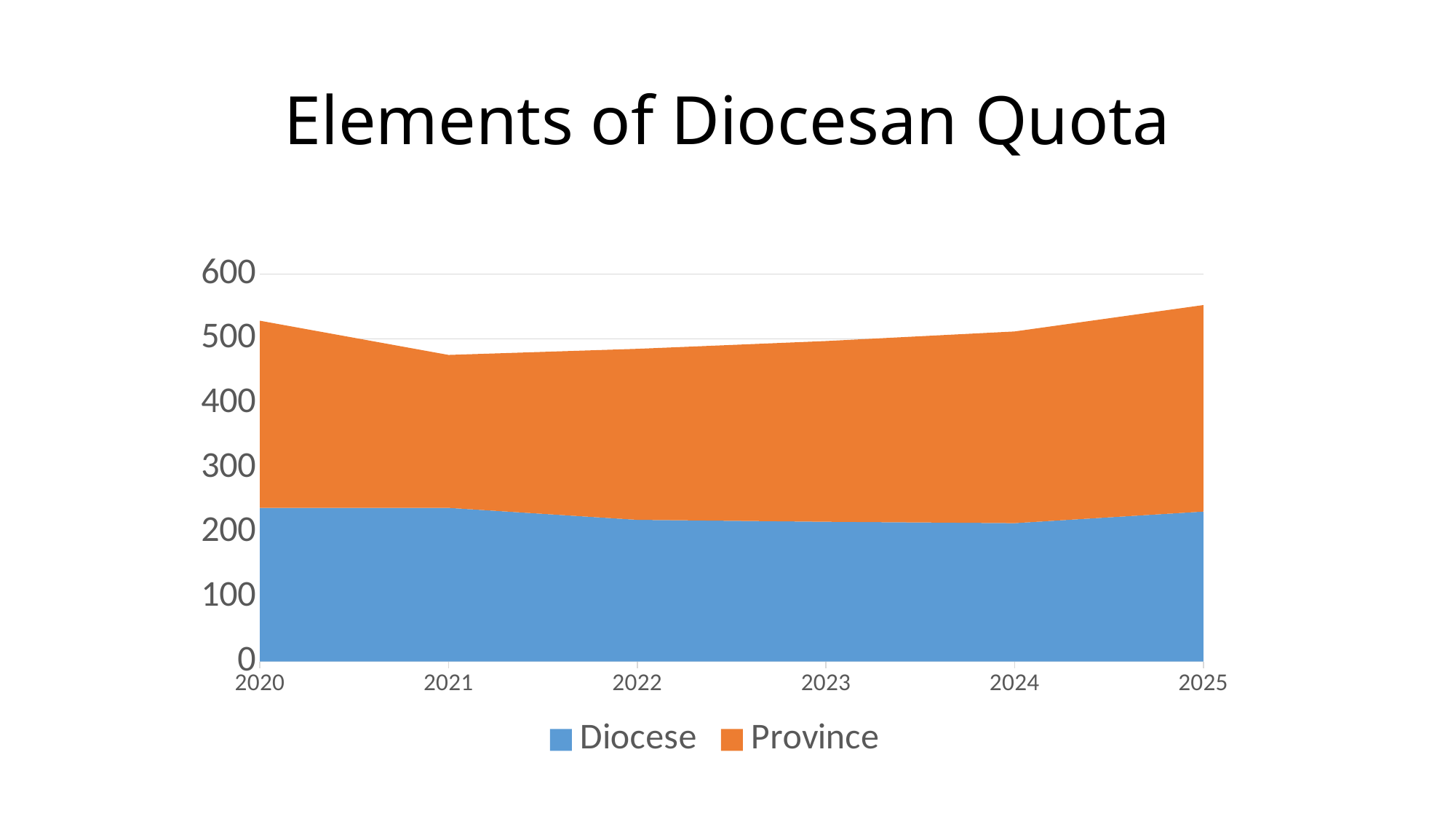
Which year has the larger combined total, 2021 or 2025? 2025 Is the combined total of Diocese and Province in 2025 greater or less than 500? greater Which colour represents the Province series? Orange What kind of chart is shown on the slide? Area chart Does the combined total of Diocese and Province rise or fall from 2021 to 2025? Rise How many series does the legend list? 2 In which year is the combined total of Diocese and Province lowest? 2021 In which year is the combined total of Diocese and Province highest? 2025 What is the title of the chart? Elements of Diocesan Quota How many years are plotted along the x axis? 6 Is the value for Diocese in 2020 greater or less than 200? greater Is the combined total of Diocese and Province in 2021 greater or less than 500? less